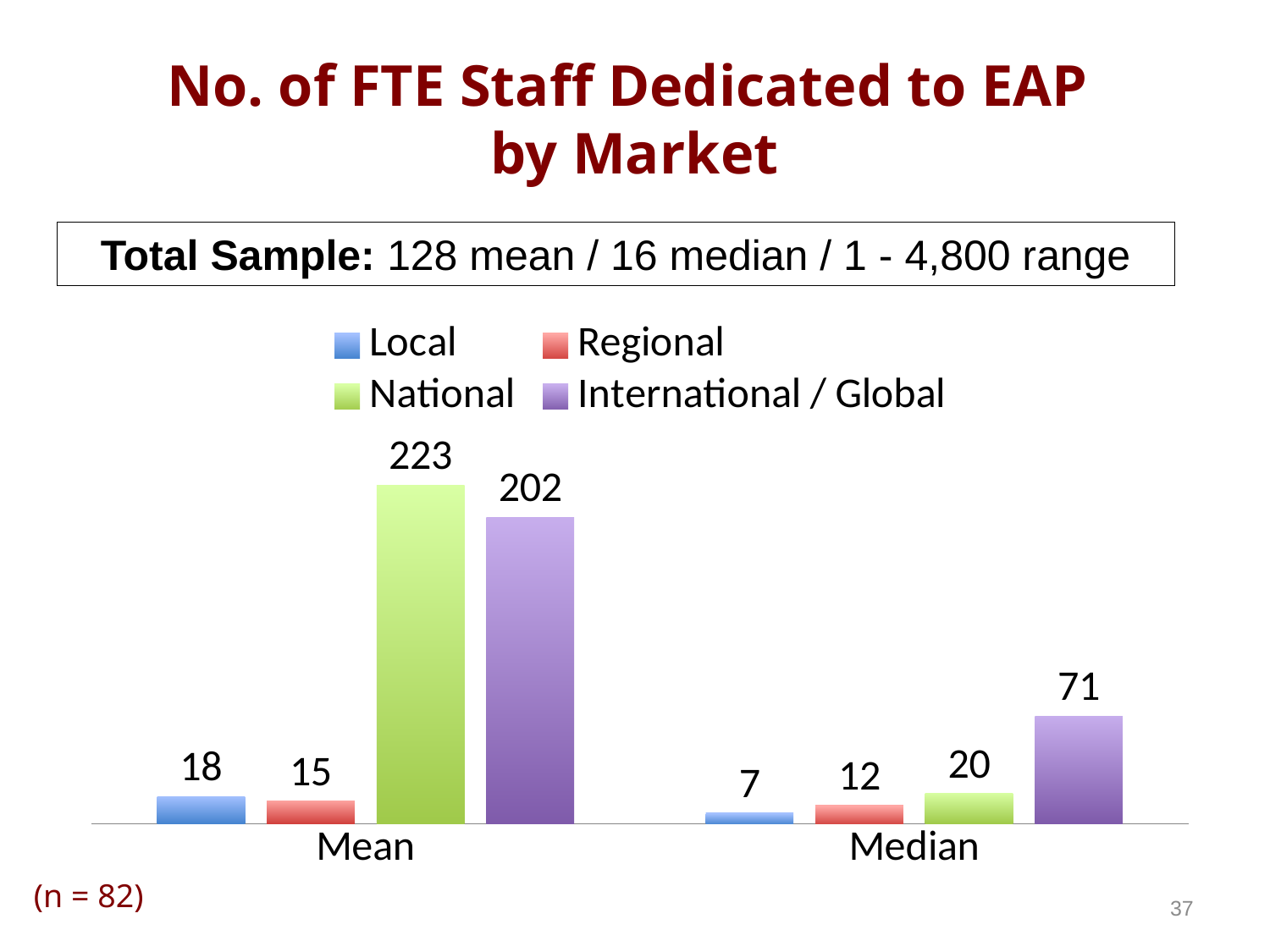
Which is larger, the mean value for Local or the mean value for Regional? Local What is the median value for the Regional market? 12 What is the title of the chart? No. of FTE Staff Dedicated to EAP by Market What is the mean value for the Local market? 18 What is the mean number of FTE staff for the National market? 223 What is the difference between the mean values for National and International / Global? 21 Which market has the lowest median number of FTE staff? Local What is the difference between the median values for International / Global and National? 51 What is the median number of FTE staff for the International / Global market? 71 Which market has the highest mean number of FTE staff? National What kind of chart is shown on the slide? Bar chart How many series does the legend list? 4